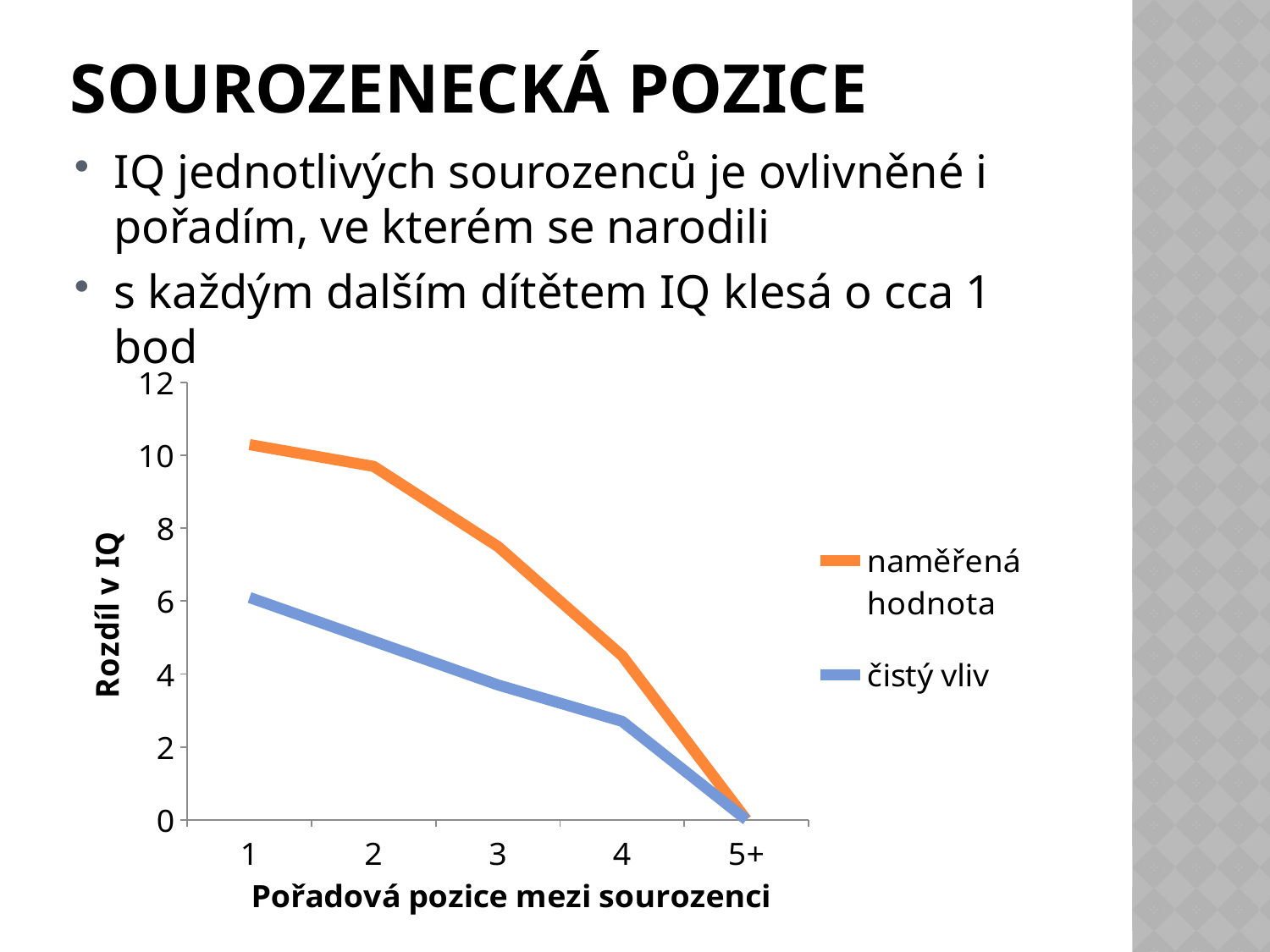
How many positions are shown along the x axis of the chart? 5 Do the values of the 'naměřená hodnota' series rise or fall as the sibling position increases from 1 to 5+? fall How many series does the chart legend list? 2 At which sibling position does the 'naměřená hodnota' series have its highest value? 1 At position 2, which series has the larger value, 'naměřená hodnota' or 'čistý vliv'? naměřená hodnota Is the value of 'čistý vliv' at position 1 greater or less than 8? less What is the title of the chart's y axis? Rozdíl v IQ At which sibling position does the 'čistý vliv' series reach its lowest value? 5+ Is the value of 'čistý vliv' at position 4 greater or less than 4? less Is the value of 'naměřená hodnota' at position 1 greater or less than 10? greater What kind of chart is shown on the slide? line chart